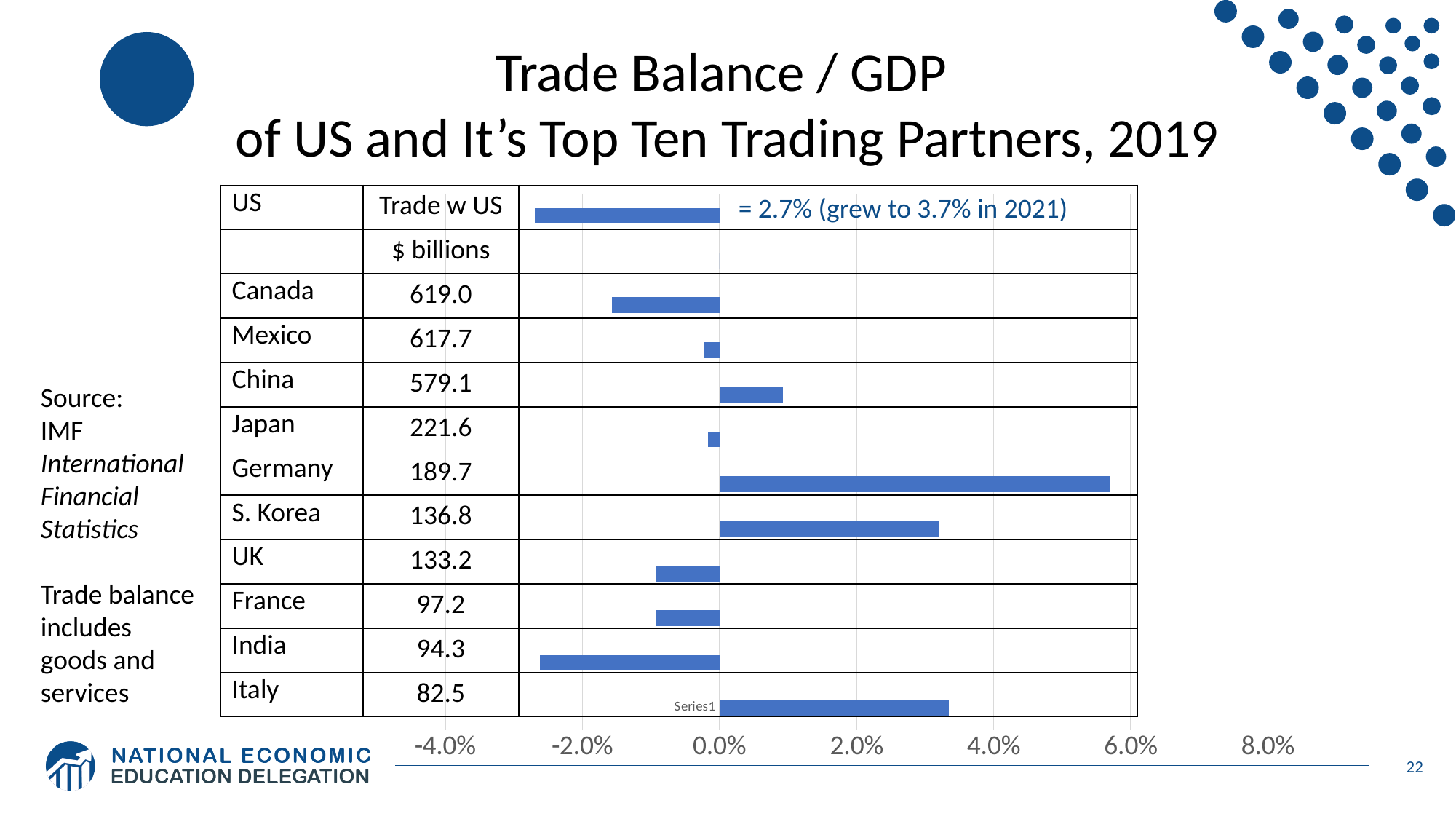
Is the value for India greater or less than -2.0%? less Is the value for Germany greater or less than 6.0%? less What kind of chart is shown on the slide? bar chart Is the value for S. Korea greater or less than 2.0%? greater Which has the larger trade balance / GDP, Germany or S. Korea? Germany Which country has the highest trade balance / GDP in the chart? Germany According to the annotation on the chart, what is the US trade balance / GDP value in 2019? 2.7% Which has the more negative trade balance / GDP, Canada or the UK? Canada According to the annotation on the chart, what did the US trade balance / GDP grow to in 2021? 3.7% How many countries (including the US) have bars in the chart? 11